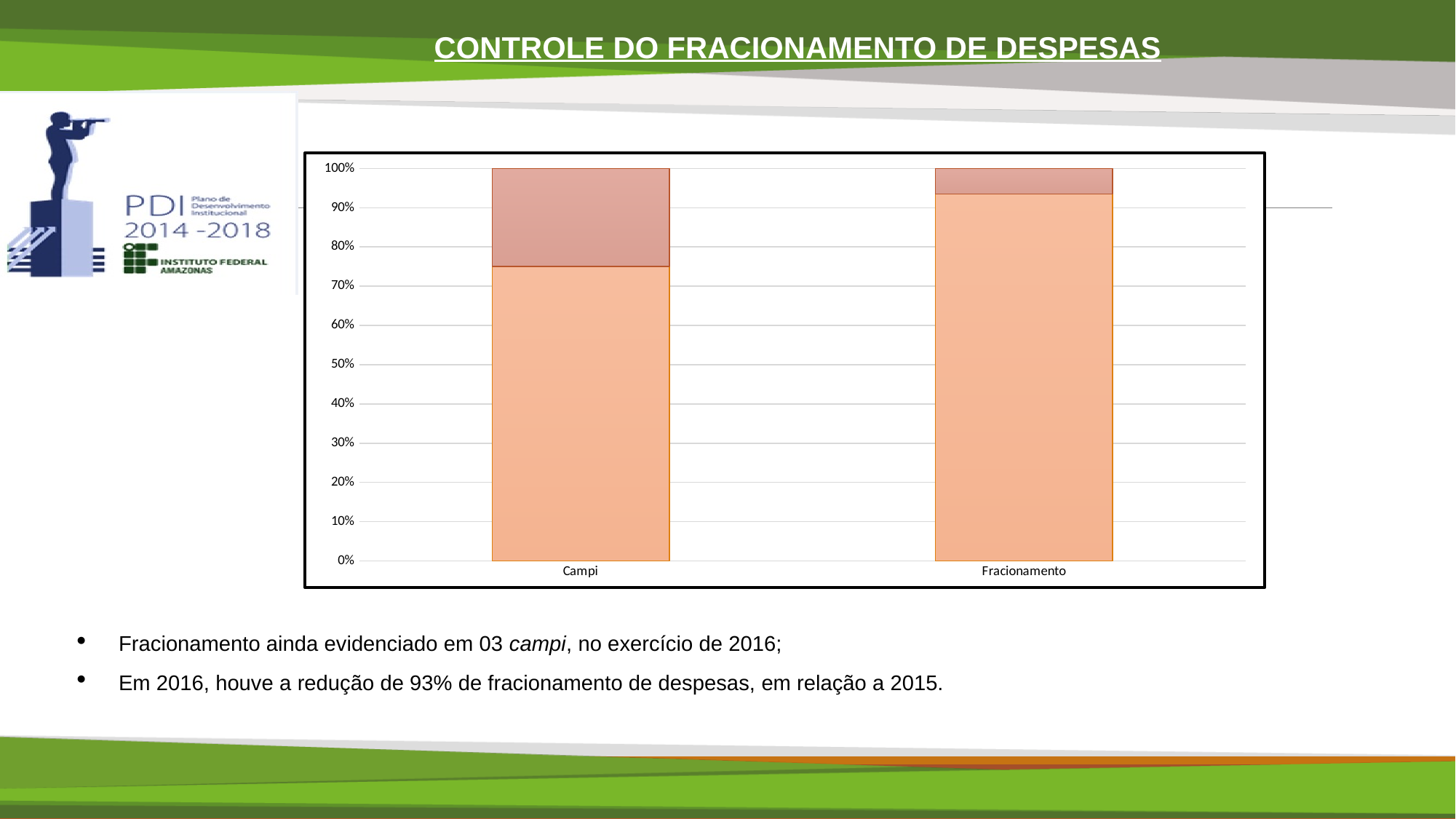
How many categories are shown on the x axis of the chart? 2 Which bar has the larger upper (darker) segment, Campi or Fracionamento? Campi Is the lower (lighter) segment of the Campi bar greater or less than 80%? less What kind of chart is shown on the slide? stacked bar chart What is the total height of the stacked bar for Campi? 100% What is the total height of the stacked bar for Fracionamento? 100% Is the upper (darker) segment of the Fracionamento bar greater or less than 10%? less Which bar has the larger lower (lighter) segment, Campi or Fracionamento? Fracionamento Is the upper (darker) segment of the Campi bar greater or less than 20%? greater What are the two category labels on the x axis of the chart? Campi and Fracionamento